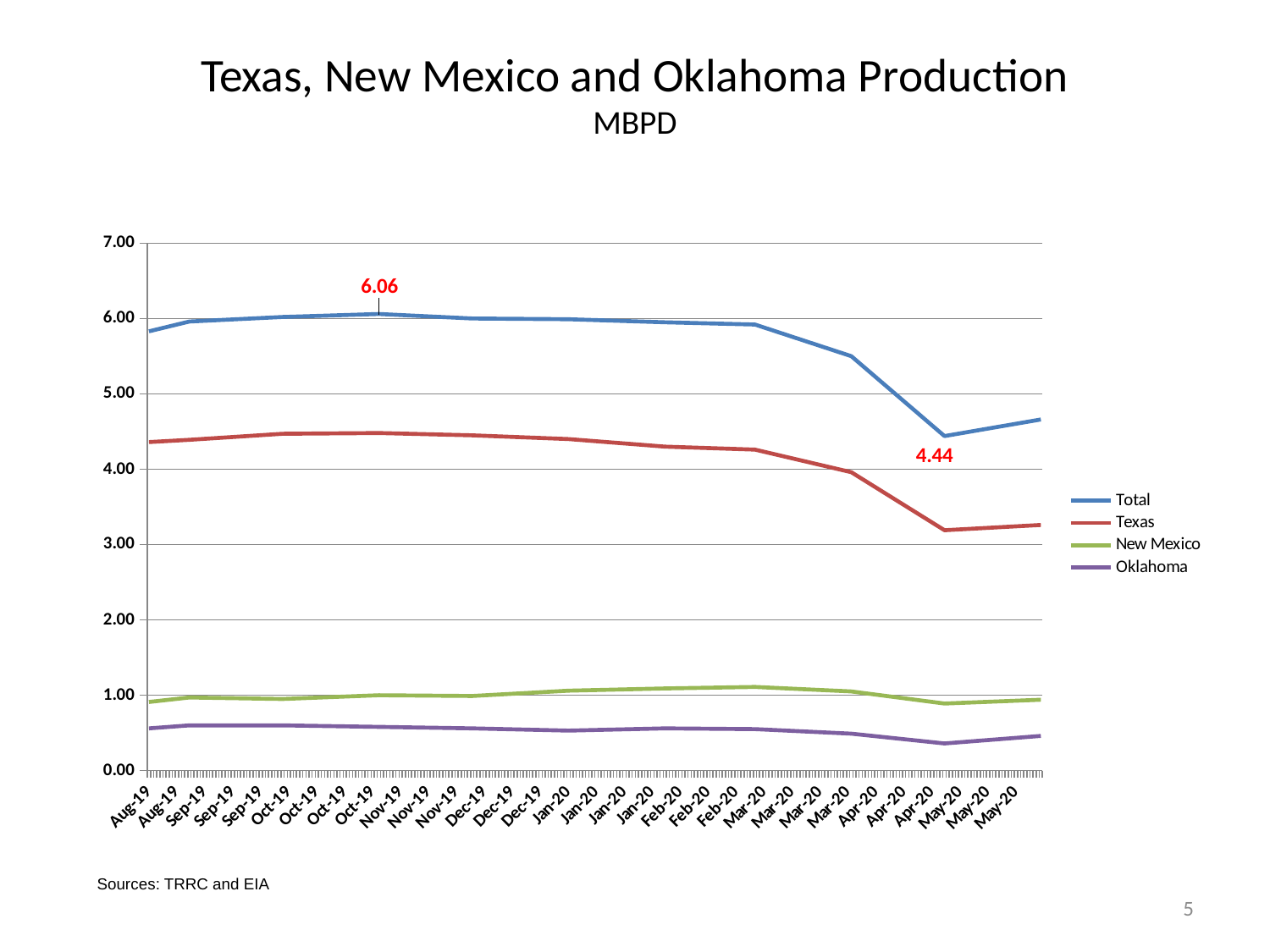
How many series does the legend list? 4 What unit is given in the chart's subtitle? MBPD Which series is lower across the whole chart, Texas or New Mexico? New Mexico What is the highest labeled value of the Total series? 6.06 What is the difference between the two labeled values on the Total line, 6.06 and 4.44? 1.62 Is the value for Texas at May-20 greater or less than 4.00? less Is the value for Total at May-20 greater or less than 5.00? less Which series has the lowest values throughout the chart? Oklahoma Are the Oklahoma values greater or less than 1.00 across the chart? less Does the Total series rise or fall between Mar-20 and Apr-20? fall What is the lowest labeled value of the Total series? 4.44 What kind of chart is shown on the slide? line chart